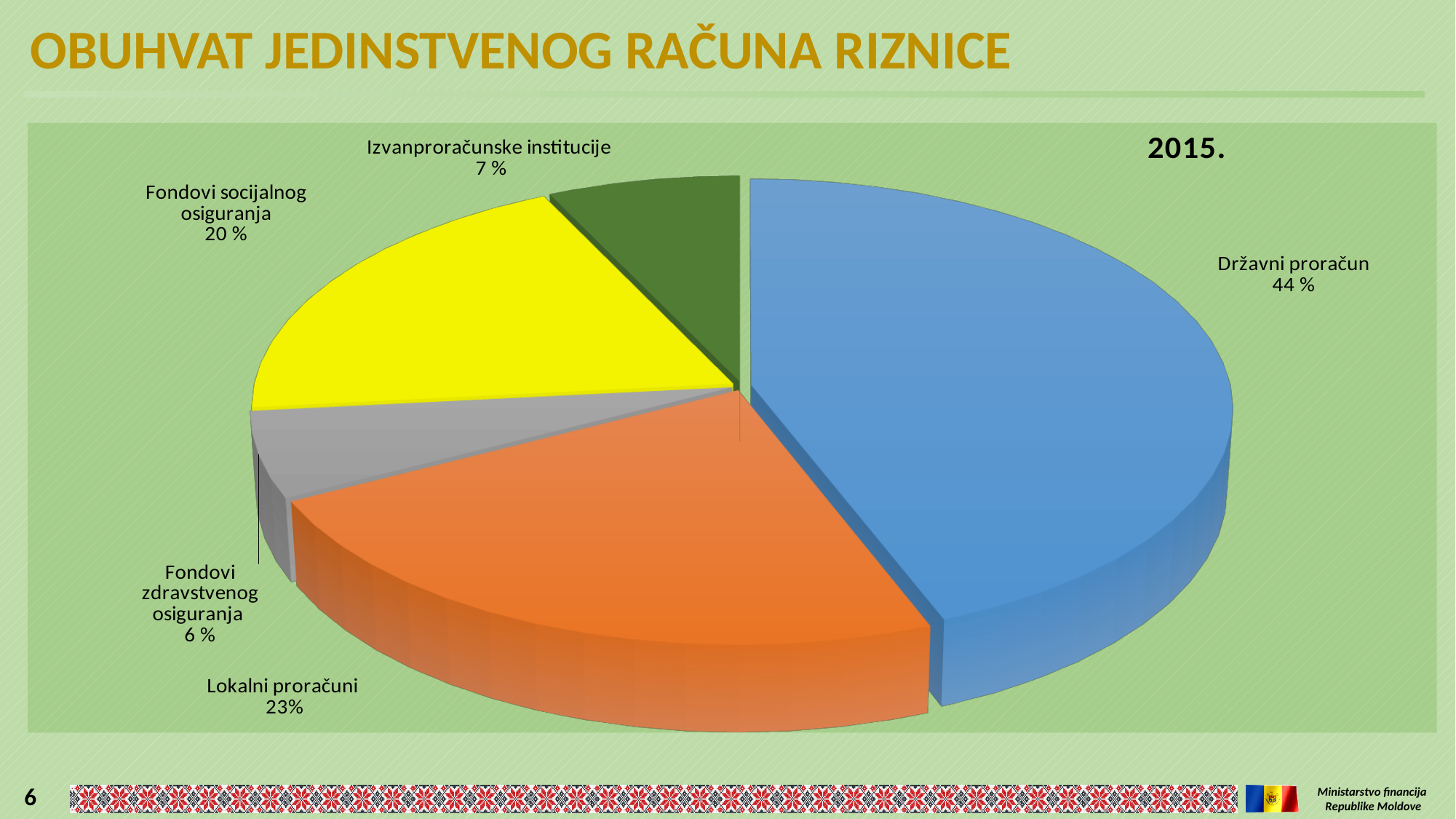
What share of the pie does Lokalni proračuni have? 23% What is the difference in percentage points between Državni proračun and Lokalni proračuni? 21 What share of the pie does Državni proračun have? 44 % Which is larger, Fondovi socijalnog osiguranja or Lokalni proračuni? Lokalni proračuni What share of the pie does Fondovi zdravstvenog osiguranja have? 6 % How many slices does the pie chart have? 5 What share of the pie does Izvanproračunske institucije have? 7 % What share of the pie does Fondovi socijalnog osiguranja have? 20 % Which year is shown on the chart? 2015 Which category has the largest slice of the pie? Državni proračun Which category has the smallest slice of the pie? Fondovi zdravstvenog osiguranja What kind of chart is shown on the slide? Pie chart